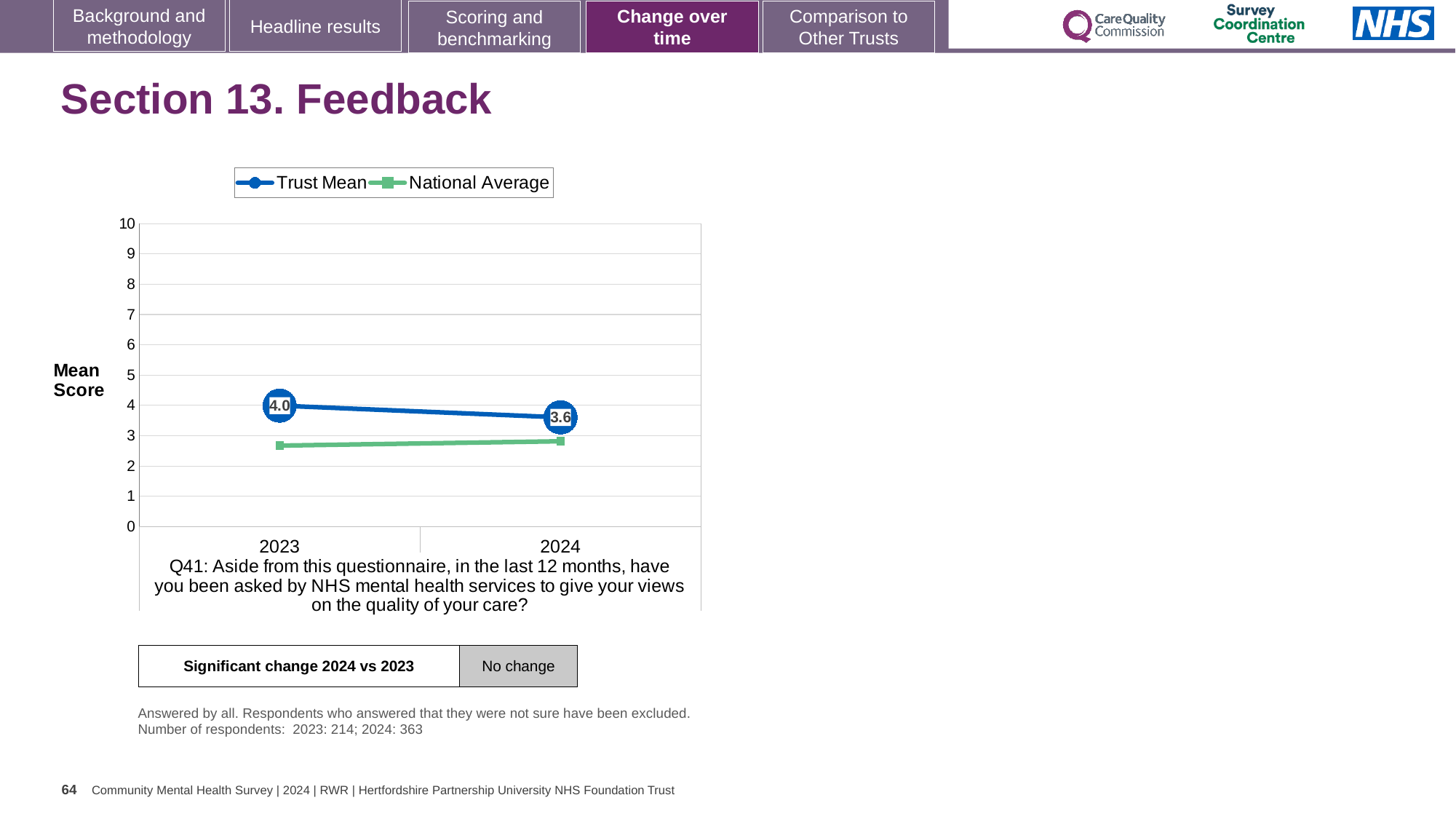
How many series does the legend list? 2 By how much did the Trust Mean score change from 2023 to 2024? 0.4 How many years are plotted on the x axis? 2 What type of chart is shown on the slide? line chart In 2023, which is higher: the Trust Mean or the National Average? Trust Mean Is the National Average for 2024 greater or less than 2? greater In 2024, which is higher: the Trust Mean or the National Average? Trust Mean In which year is the Trust Mean score higher, 2023 or 2024? 2023 Is the National Average for 2023 greater or less than 3? less What is the Trust Mean score for 2023? 4.0 What is the Trust Mean score for 2024? 3.6 Does the Trust Mean score rise or fall from 2023 to 2024? fall